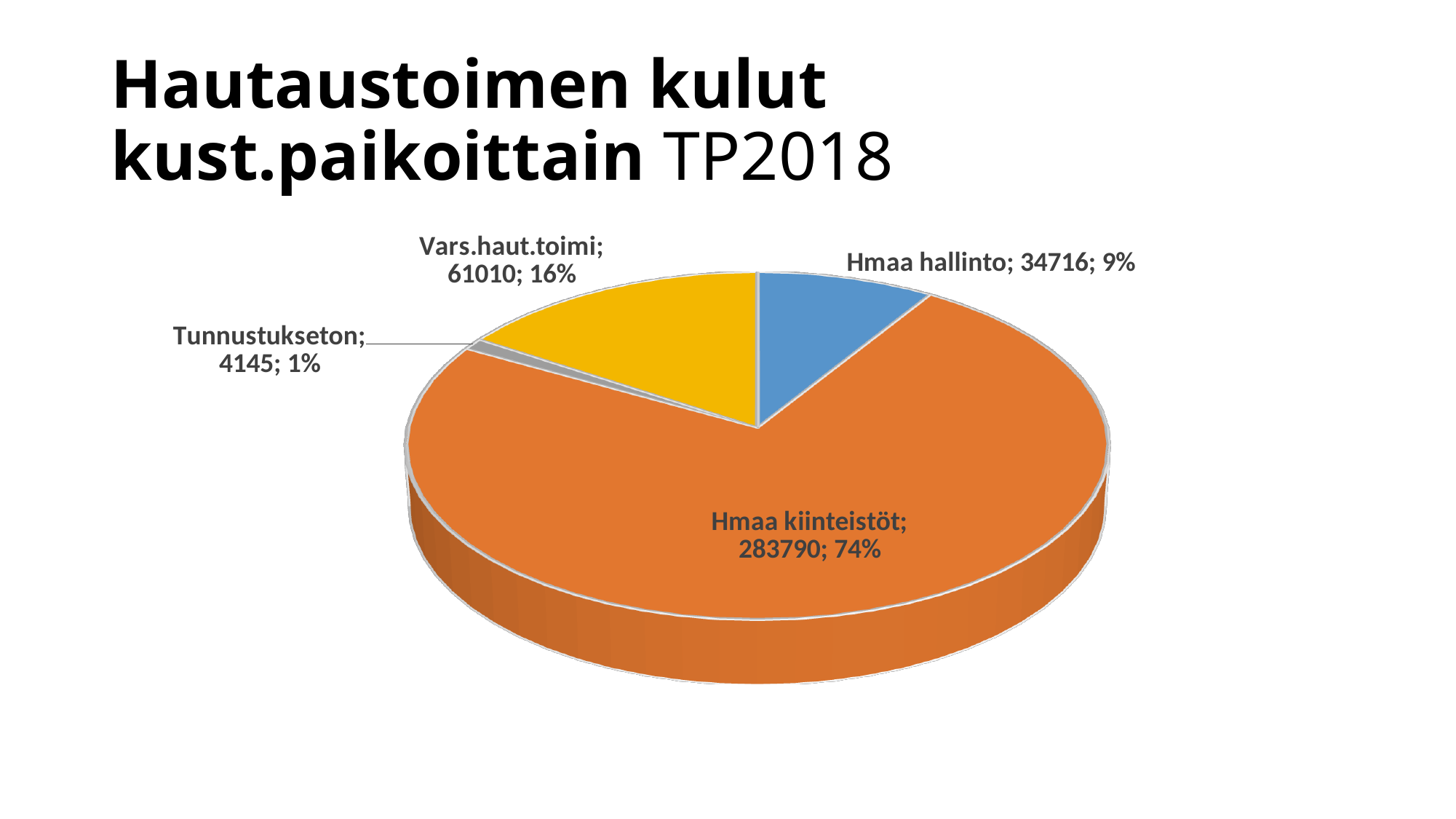
What share of the pie does Vars.haut.toimi represent? 16% What is the value for Tunnustukseton? 4145 What share of the pie does Hmaa hallinto represent? 9% What is the difference between the values for Vars.haut.toimi and Hmaa hallinto? 26294 What kind of chart is shown on the slide? Pie chart What is the value for Vars.haut.toimi? 61010 What is the value for Hmaa kiinteistöt? 283790 Which is larger, the value for Hmaa hallinto or the value for Tunnustukseton? Hmaa hallinto Which category has the largest slice of the pie? Hmaa kiinteistöt Which category has the smallest slice of the pie? Tunnustukseton How many categories are shown in the pie chart? 4 What is the value for Hmaa hallinto? 34716